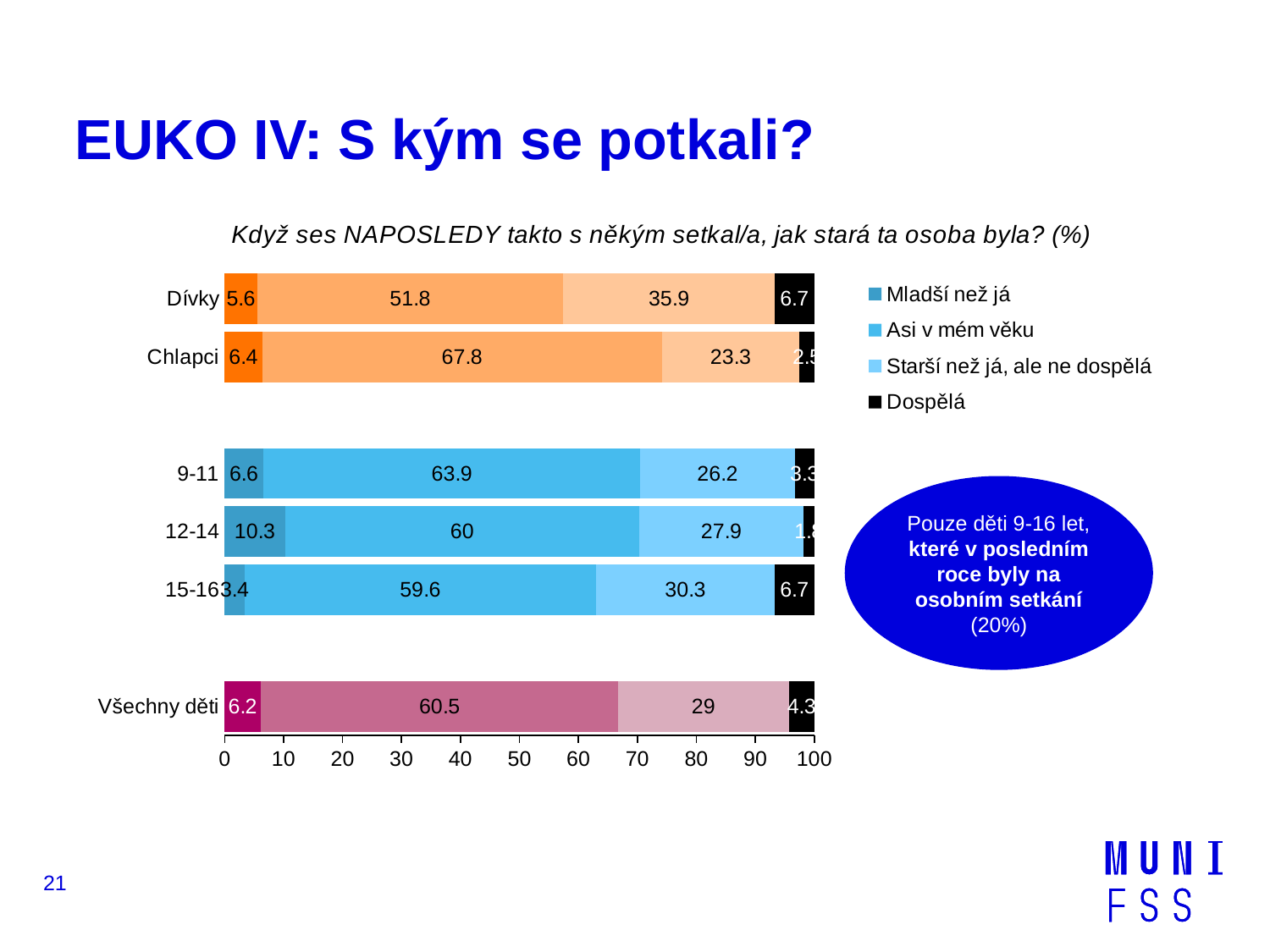
Which is larger: the 'Starší než já, ale ne dospělá' value for Dívky or for Všechny děti? Dívky What kind of chart is shown on the slide? bar chart What is the value of 'Starší než já, ale ne dospělá' for Chlapci? 23.3 What is the value of 'Mladší než já' for the 12-14 age group? 10.3 What is the value of 'Dospělá' for the 15-16 age group? 6.7 How many categories (bars) are plotted in the chart? 6 Which category has the lowest value for 'Mladší než já'? 15-16 What is the difference between the 'Asi v mém věku' values for Chlapci and Dívky? 16 Which legend entry is shown in black? Dospělá What is the value of 'Asi v mém věku' for Dívky? 51.8 How many series does the legend list? 4 Which category has the highest value for 'Asi v mém věku'? Chlapci